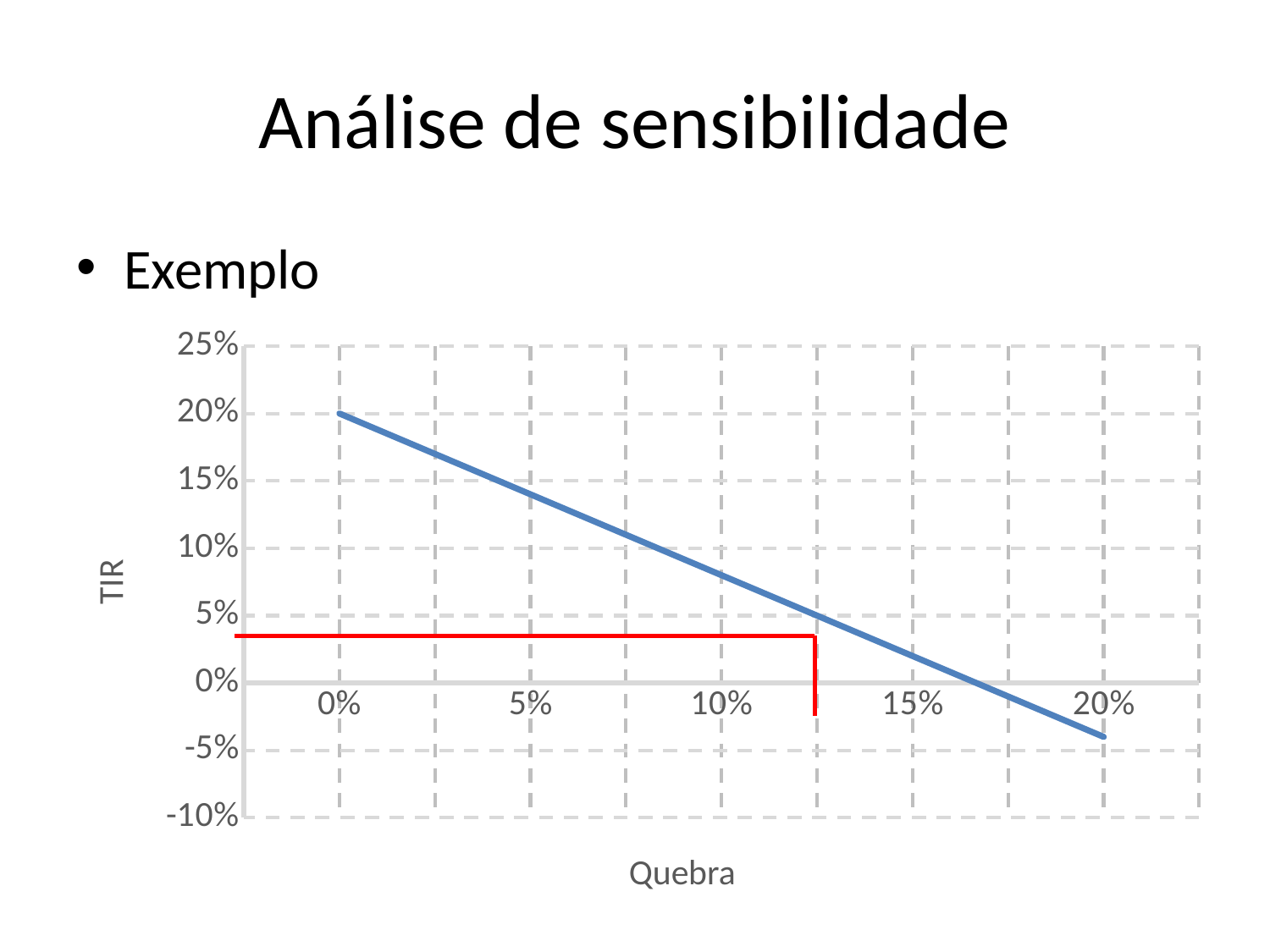
Which has a higher TIR: Quebra 5% or Quebra 15%? Quebra 5% What kind of chart is shown on the slide? line chart Does the TIR rise or fall as Quebra increases along the x axis? fall What is the TIR value when Quebra is 0%? 20% Is the TIR value at Quebra 20% greater or less than 0%? less At which Quebra value is the TIR highest? 0% At which Quebra value is the TIR lowest? 20% Is the TIR value at Quebra 10% greater or less than 5%? greater Is the TIR value at Quebra 15% greater or less than 5%? less What is the title of the x axis? Quebra What is the title of the y axis? TIR